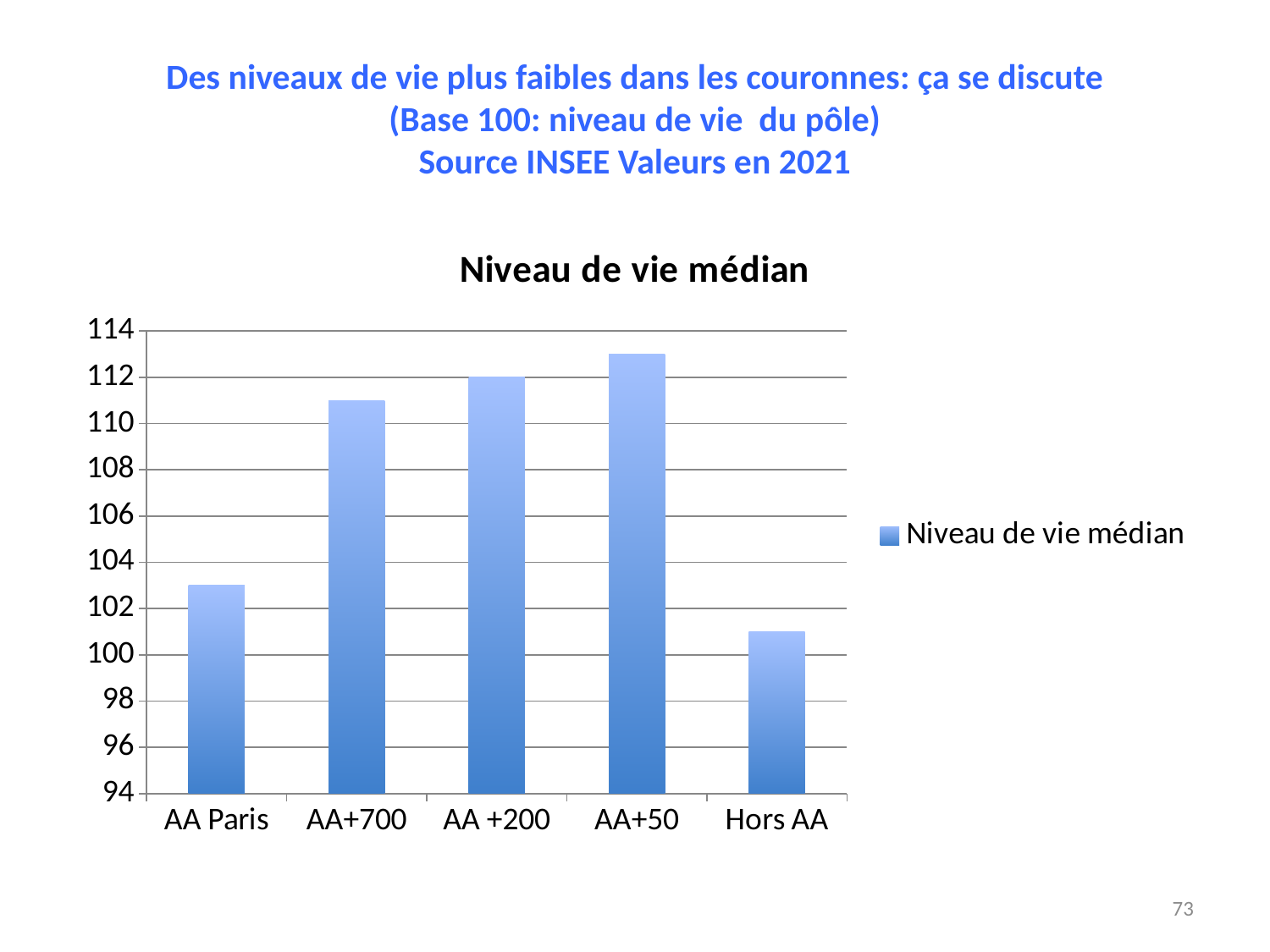
Is the value for AA+700 greater or less than 110? greater Which is larger, the value for Hors AA or the value for AA Paris? AA Paris Which category has the lowest value for Niveau de vie médian? Hors AA What is the value for AA +200? 112 Which is larger, the value for AA Paris or the value for AA+700? AA+700 What kind of chart is shown on the slide? bar chart How many categories are shown on the x axis of the chart? 5 Is the value for AA Paris greater or less than 104? less How many series does the legend list? 1 What is the title of the chart? Niveau de vie médian Is the value for Hors AA greater or less than 100? greater Which category has the highest value for Niveau de vie médian? AA+50